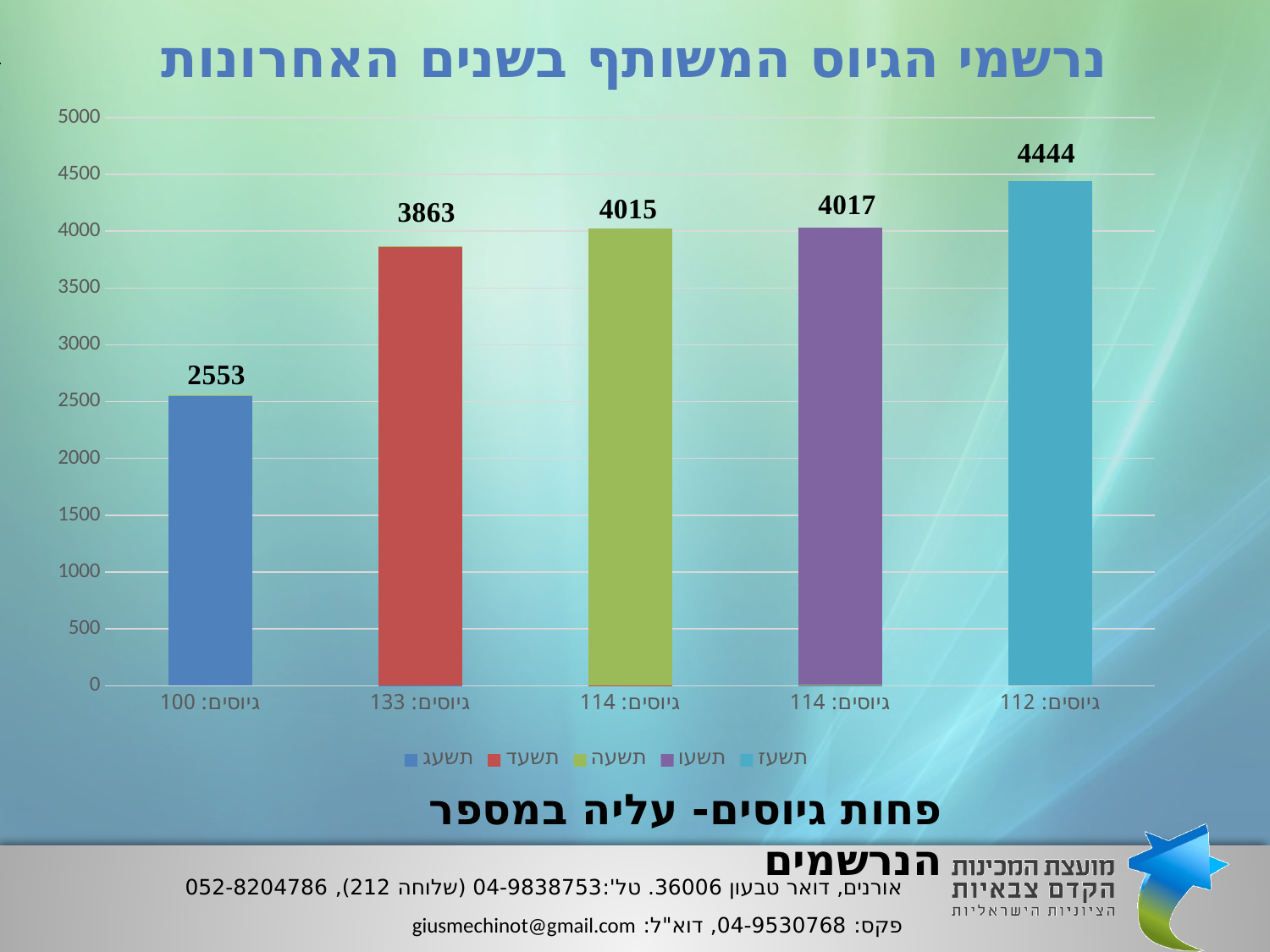
What is the difference between the values for תשעז and תשעג? 1891 What is the value of the bar for תשעד (the red bar, labelled גיוסים: 133)? 3863 What is the value of the bar for תשעג (the blue bar, labelled גיוסים: 100)? 2553 What is the difference between the values for תשעד and תשעג? 1310 What kind of chart is shown on the slide? bar chart How many entries does the legend list? 5 Which year (legend entry) has the highest bar? תשעז Is the value for תשעג greater or less than 3000? less Which year (legend entry) has the lowest bar? תשעג How many bars are shown in the chart? 5 What is the value of the bar for תשעז (the rightmost bar, labelled גיוסים: 112)? 4444 Which is larger, the value for תשעד or the value for תשעז? תשעז